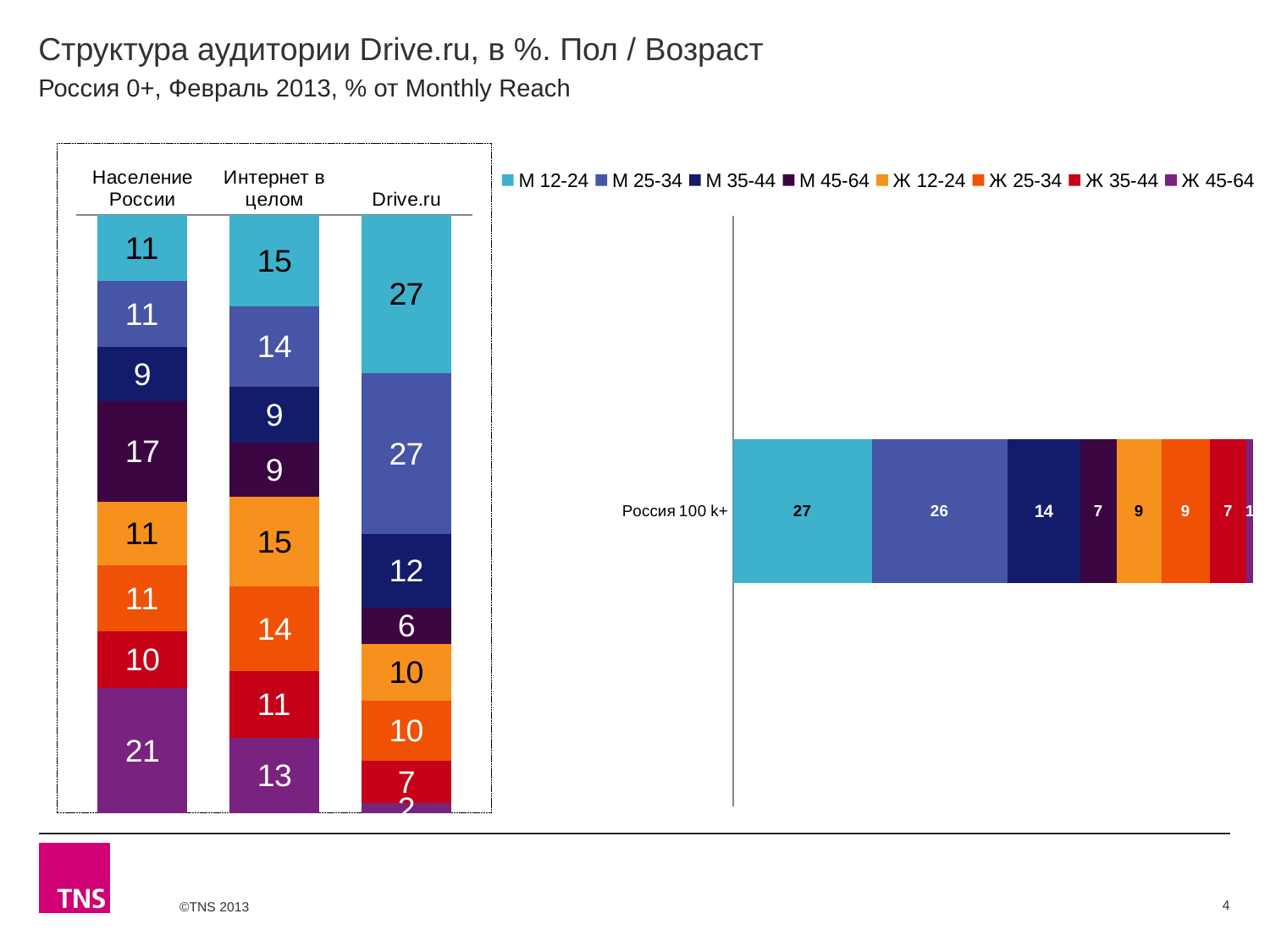
In the right chart, what is the total of the Россия 100 k+ bar? 100 In the left chart, which segment is the smallest in the Drive.ru bar? Ж 45-64 How many series does the legend list? 8 In the left chart, which segment is the largest in the Население России bar? Ж 45-64 What kind of chart is the right chart (Россия 100 k+)? Stacked bar chart In the right chart, what is the value of the М 25-34 segment for Россия 100 k+? 26 In the left chart, what is the value of the Ж 45-64 segment for Население России? 21 In the left chart, which is larger for Drive.ru: the М 35-44 segment or the Ж 12-24 segment? М 35-44 How many bars (categories) does the left chart show? 3 In the left chart, what is the value of the М 45-64 segment for Интернет в целом? 9 In the left chart, what is the difference between the М 45-64 values for Население России and Drive.ru? 11 In the left chart, what is the value of the М 12-24 segment for Drive.ru? 27